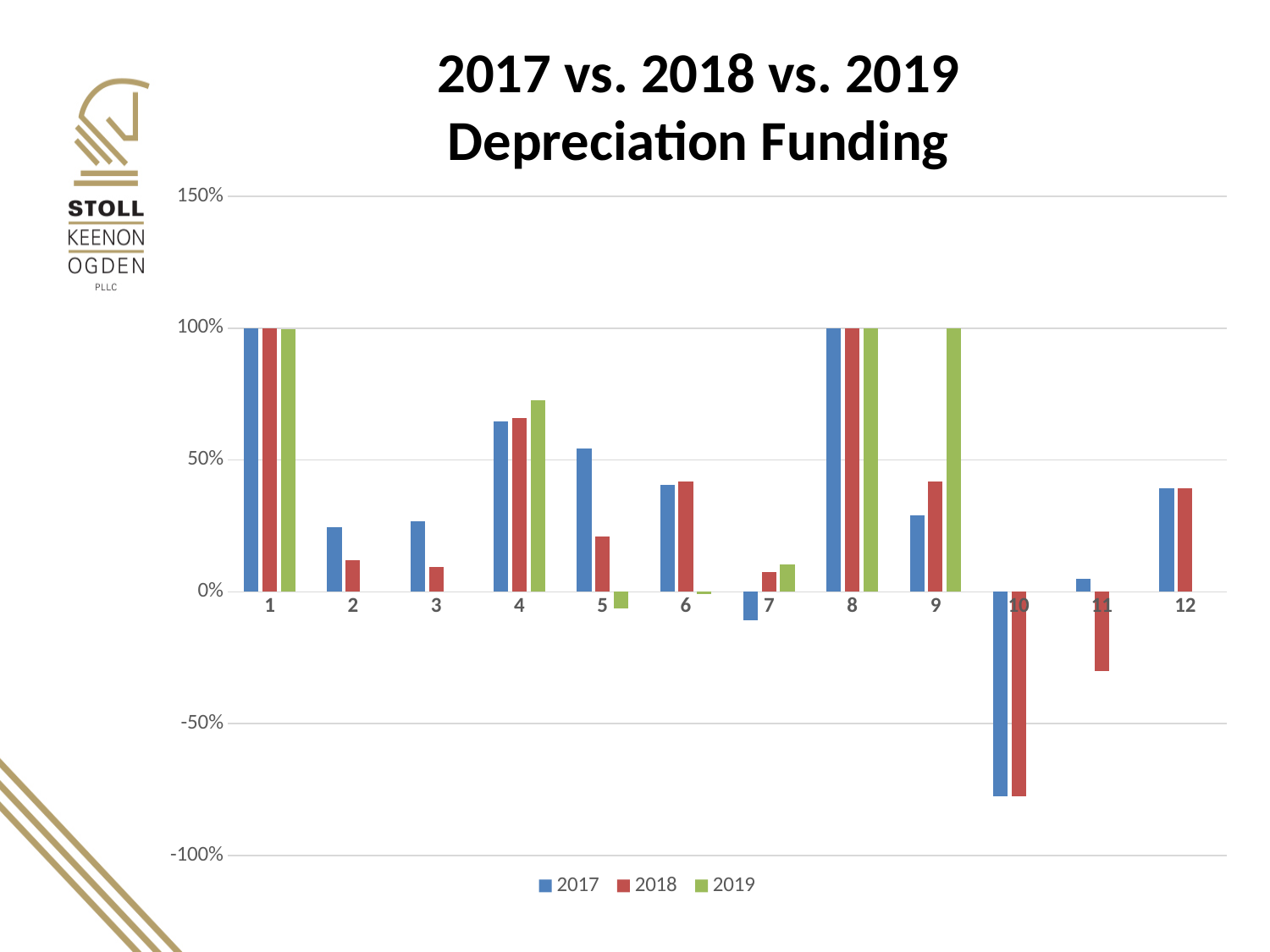
How many categories are shown on the x axis? 12 Is the 2018 value for category 11 greater or less than -50%? greater What is the title of the chart? 2017 vs. 2018 vs. 2019 Depreciation Funding For category 5, which is larger: the 2017 value or the 2018 value? 2017 What is the 2019 value for category 9? 100% What is the 2019 value for category 8? 100% Is the 2017 value for category 10 greater or less than -50%? less How many series does the legend list? 3 What type of chart is shown on the slide? bar chart Is the 2019 value for category 4 greater or less than 50%? greater Which category has the lowest 2018 value? 10 What is the 2017 value for category 1? 100%